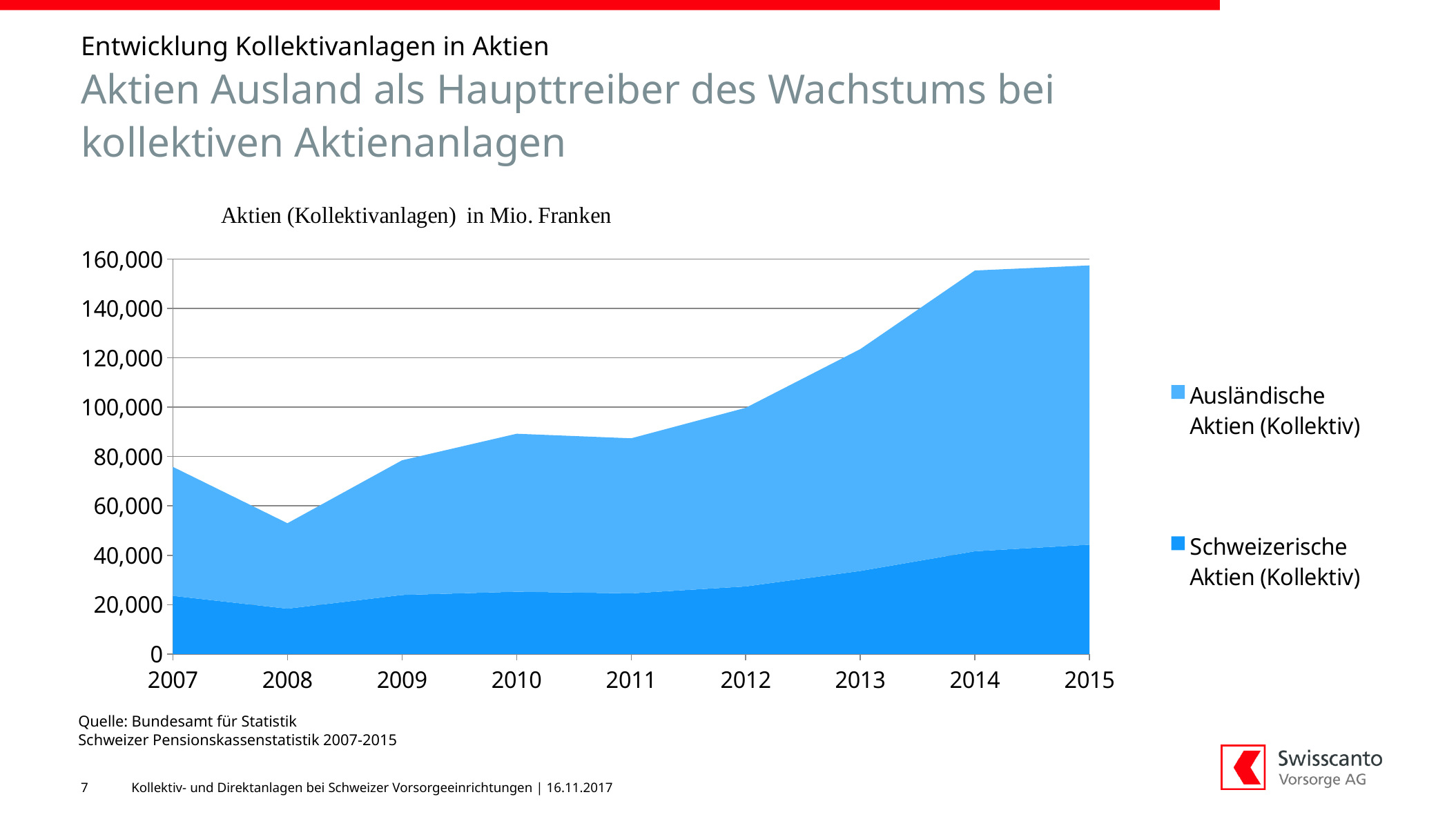
Is the total value of the stacked areas in 2015 greater or less than 140,000? greater What kind of chart is shown on the slide? Stacked area chart Does the total of the stacked areas rise or fall from 2008 to 2015? rise Is the value for Schweizerische Aktien (Kollektiv) in 2015 greater or less than 40,000? greater What is the title of the chart? Aktien (Kollektivanlagen) in Mio. Franken Which series is shown in the darker blue at the bottom of the chart? Schweizerische Aktien (Kollektiv) Is the value for Schweizerische Aktien (Kollektiv) in 2008 greater or less than 20,000? less In which year is the total of the stacked areas lowest? 2008 How many series does the chart legend list? 2 In 2015, which series is larger: Ausländische Aktien (Kollektiv) or Schweizerische Aktien (Kollektiv)? Ausländische Aktien (Kollektiv) How many years are plotted along the x axis of the chart? 9